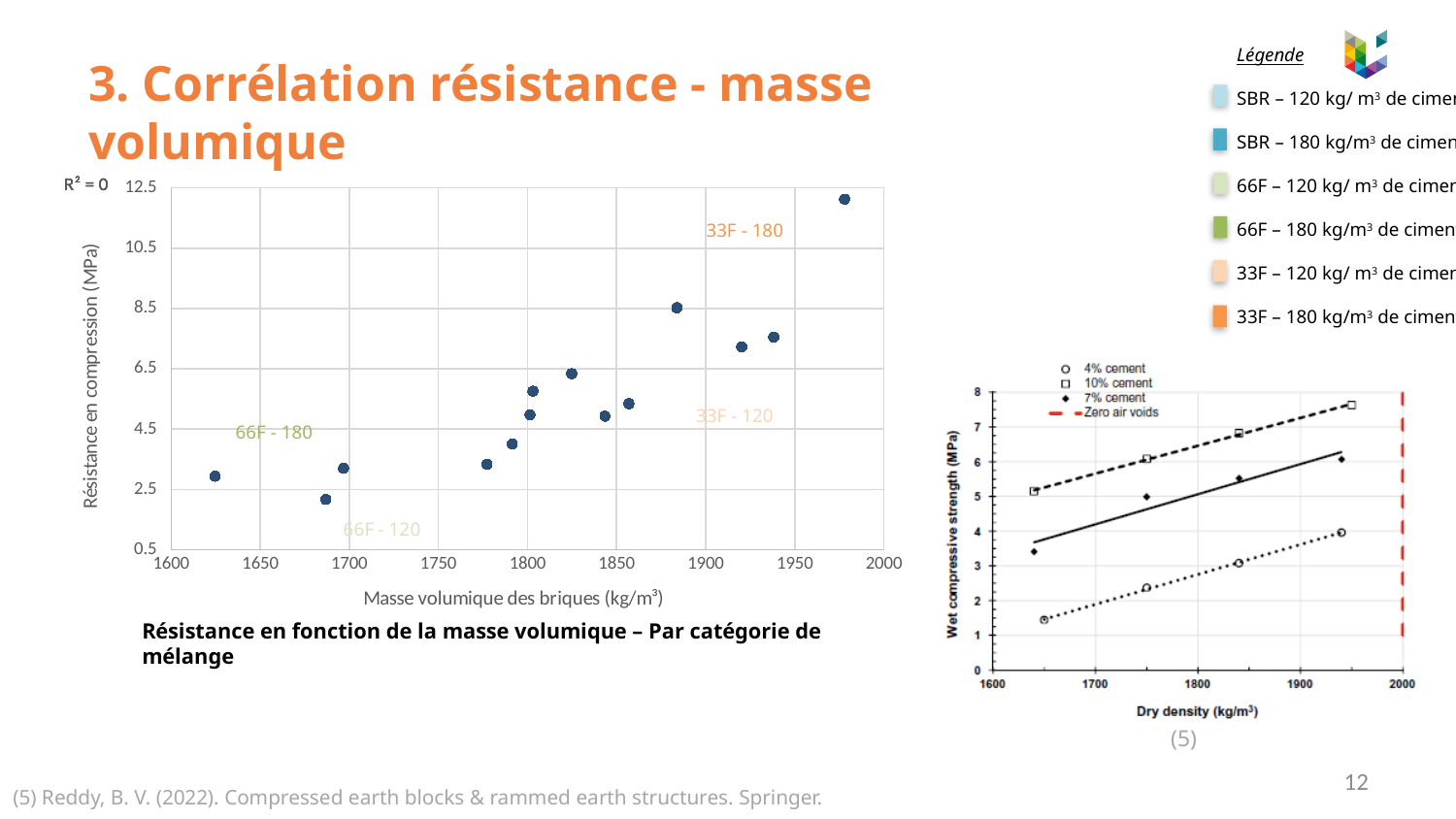
In the left chart, is the compressive strength of the point with the lowest density (near 1625 kg/m³) greater or less than 4.5 MPa? less In the left chart, do the compressive strength values generally rise or fall as the brick density increases along the x axis? rise What kind of chart is the left chart titled 'Résistance en fonction de la masse volumique – Par catégorie de mélange'? scatter chart How many entries does the legend of the right chart (Wet compressive strength vs Dry density) list? 4 What is the x-axis title of the left chart? Masse volumique des briques (kg/m³) What R² value is displayed above the left chart? R² = 0 In the left chart, is the compressive strength of the point with the highest density (near 1980 kg/m³) greater or less than 10.5 MPa? greater In the left chart, which point has the higher compressive strength: the one near 1625 kg/m³ or the one near 1885 kg/m³? the one near 1885 kg/m³ In the right chart, is the wet compressive strength of the 4% cement series at about 1650 kg/m³ greater or less than 2 MPa? less In the right chart, which cement series has the highest wet compressive strength? 10% cement In the right chart, which cement series has the lowest wet compressive strength? 4% cement